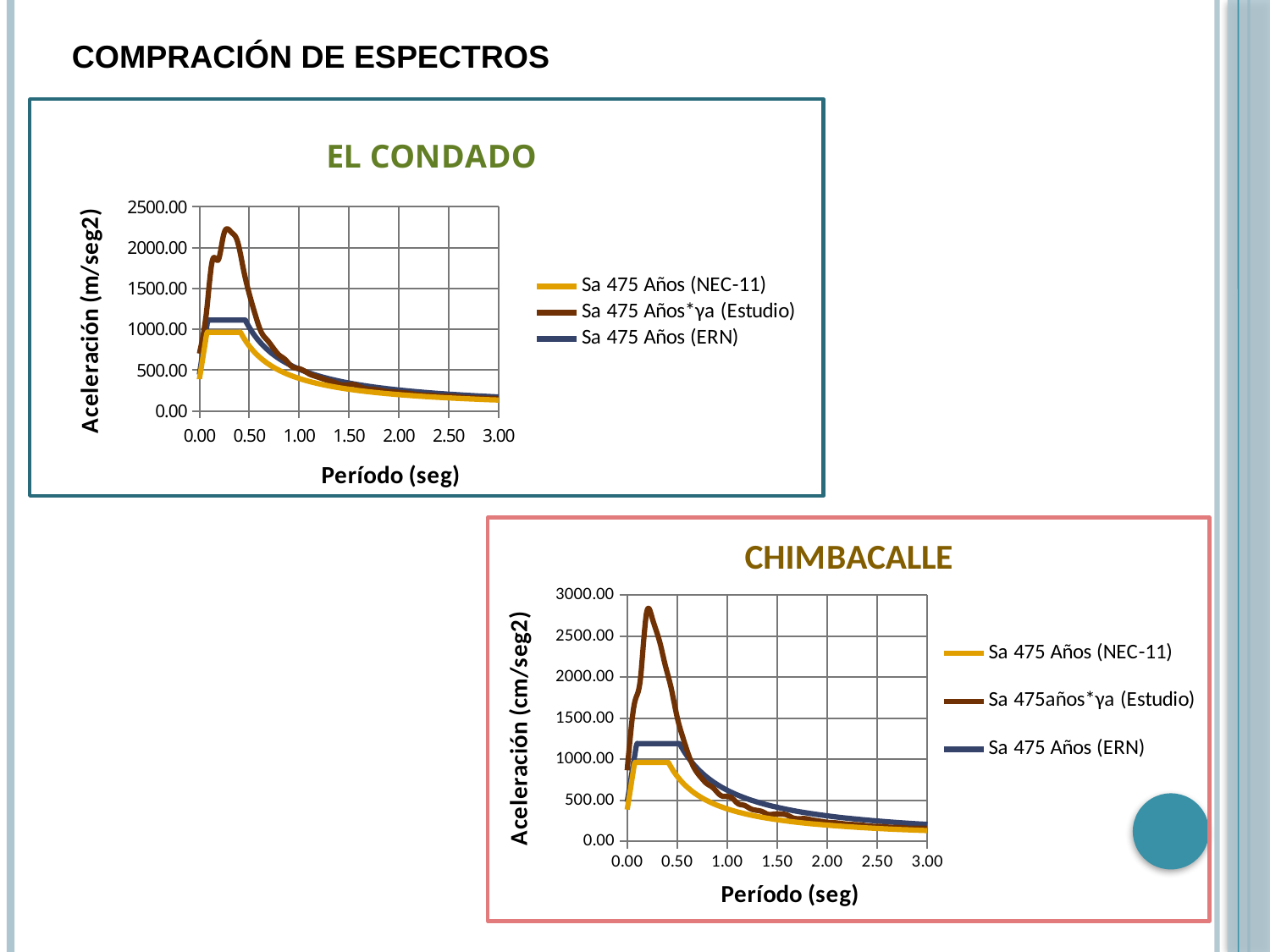
In the EL CONDADO chart, is the peak value of the Sa 475 Años*γa (Estudio) series greater or less than 2000.00? greater How many series does the legend of the CHIMBACALLE chart list? 3 In the CHIMBACALLE chart, which series reaches the highest peak acceleration? Sa 475años*γa (Estudio) In the CHIMBACALLE chart, do the values of all series rise or fall as the period increases from 1.00 to 3.00 seconds? fall What is the y-axis title of the CHIMBACALLE chart? Aceleración (cm/seg2) In the CHIMBACALLE chart, is the peak value of the Sa 475años*γa (Estudio) series greater or less than 2500.00? greater In the EL CONDADO chart, which series reaches the highest peak acceleration? Sa 475 Años*γa (Estudio) What is the x-axis title of the EL CONDADO chart? Período (seg) In the EL CONDADO chart, is the plateau value of the Sa 475 Años (ERN) series greater or less than 1000.00? greater In the EL CONDADO chart, which series has the higher plateau value: Sa 475 Años (ERN) or Sa 475 Años (NEC-11)? Sa 475 Años (ERN) What kind of chart is the EL CONDADO chart? line chart